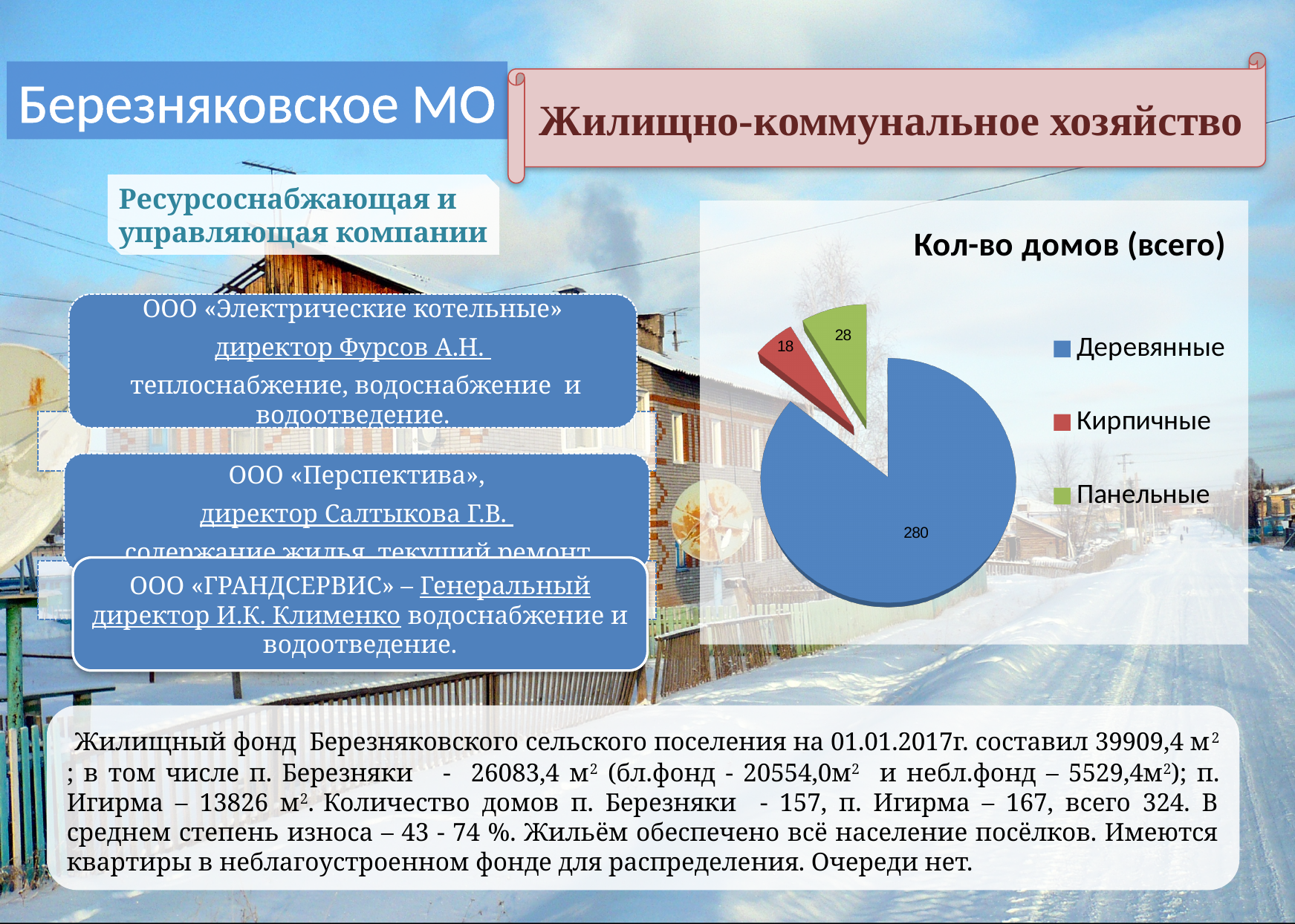
What is the difference between the values for Деревянные and Панельные? 252 What type of chart is shown on the slide? Pie chart Which category has the largest slice in the pie chart? Деревянные What is the value for Деревянные in the pie chart? 280 What is the value for Панельные in the pie chart? 28 Which category has the smallest slice in the pie chart? Кирпичные What is the title of the chart? Кол-во домов (всего) What is the value for Кирпичные in the pie chart? 18 What is the difference between the values for Панельные and Кирпичные? 10 How many categories does the pie chart show? 3 Which colour represents Панельные in the pie chart? Green Which is larger, the value for Кирпичные or the value for Панельные? Панельные